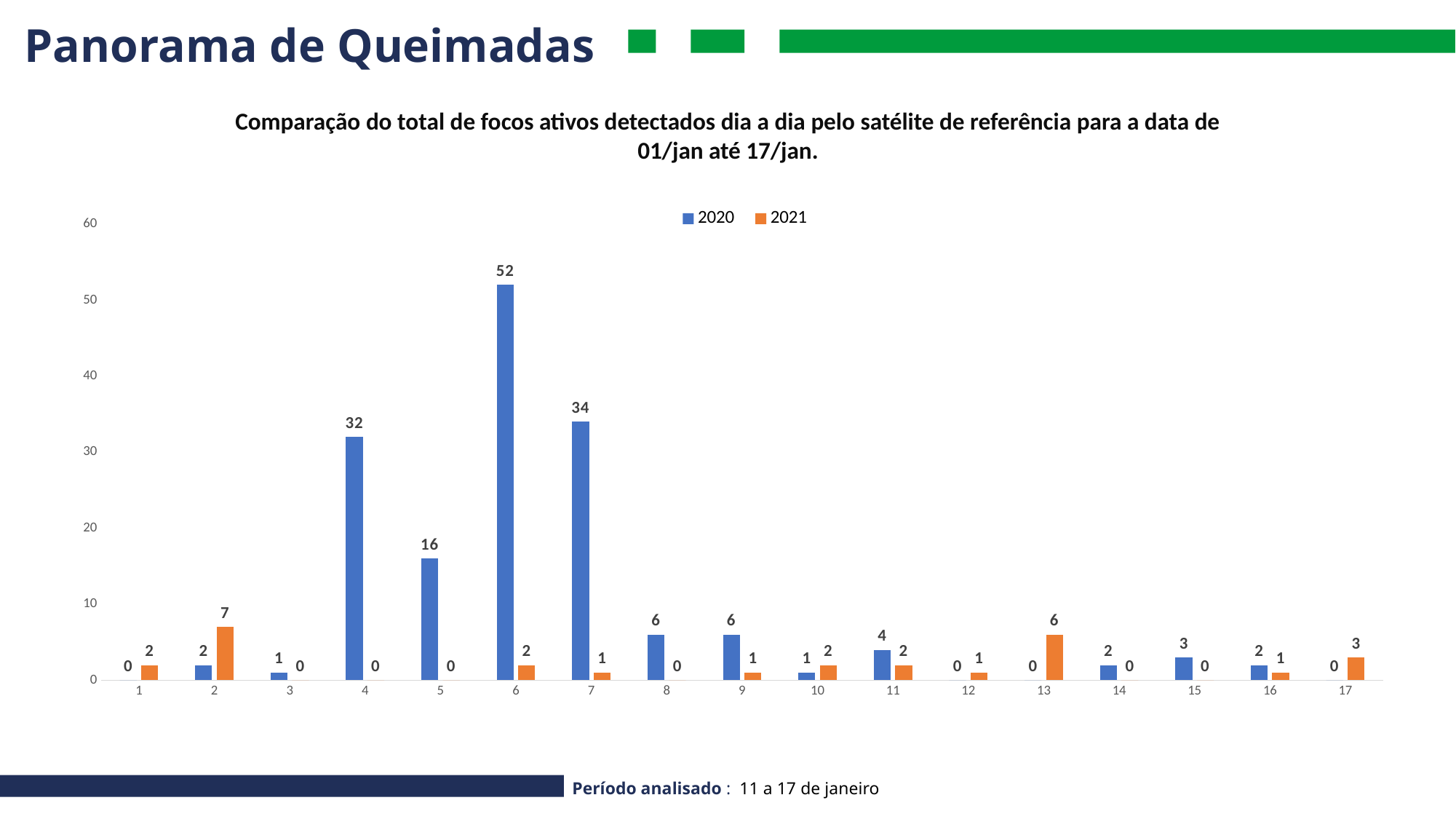
Is the 2020 value on day 7 greater or less than 30? greater What kind of chart is shown on the slide? bar chart How many days are shown on the x axis? 17 On which day is the 2021 value highest? 2 What is the value for 2020 on day 4? 32 What is the difference between the 2020 values on day 6 and day 7? 18 What is the value for 2020 on day 6? 52 On which day is the 2020 value highest? 6 What is the value for 2021 on day 2? 7 What is the value for 2021 on day 13? 6 Which is larger on day 13, the 2020 value or the 2021 value? 2021 How many series does the legend list? 2